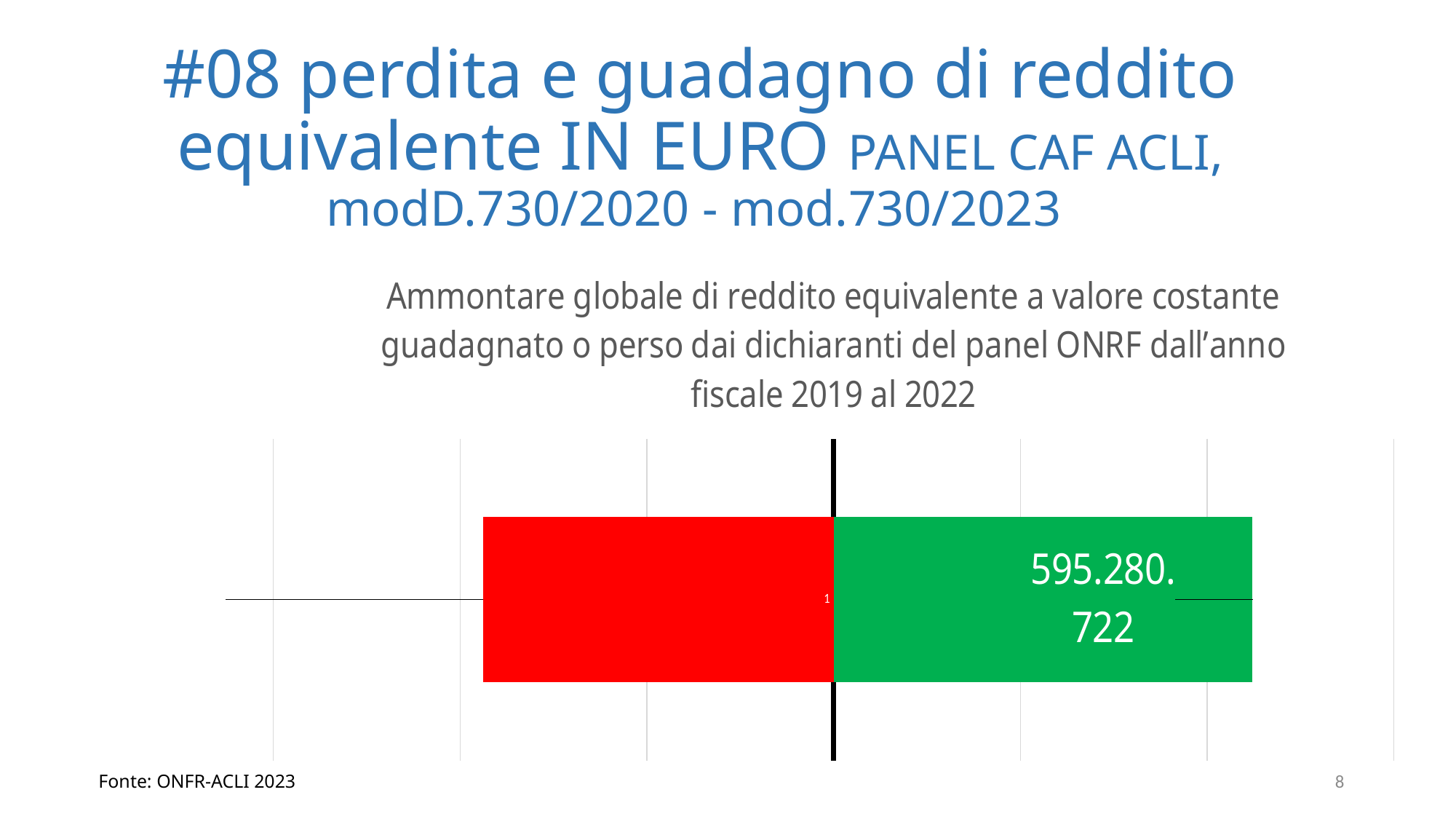
What kind of chart is shown on the slide? bar chart Which bar is the longest in the chart? the green bar Which bar extends further from the central axis, the red bar or the green bar? the green bar How many bars are plotted in the chart? 2 What is the title of the chart? Ammontare globale di reddito equivalente a valore costante guadagnato o perso dai dichiaranti del panel ONRF dall'anno fiscale 2019 al 2022 Which bar is the shortest in the chart? the red bar What value is printed on the green bar? 595.280.722 What colour is the bar that carries the label 595.280.722? green